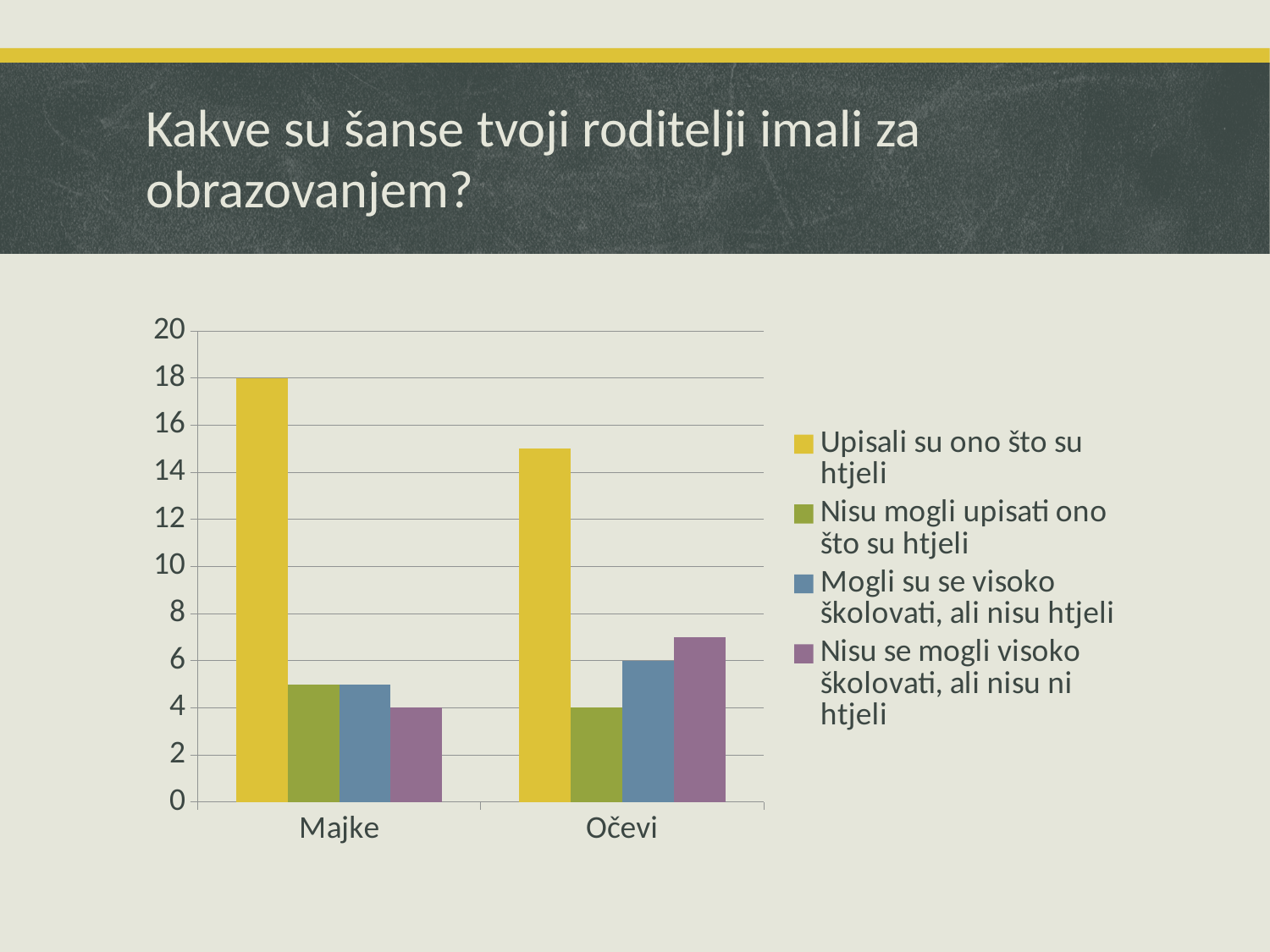
What is the value for 'Nisu mogli upisati ono što su htjeli' in the Očevi category? 4 What colour are the bars for 'Upisali su ono što su htjeli'? yellow What is the value for 'Mogli su se visoko školovati, ali nisu htjeli' in the Očevi category? 6 Which is larger: 'Upisali su ono što su htjeli' for Majke or for Očevi? Majke What is the value for 'Nisu se mogli visoko školovati, ali nisu ni htjeli' in the Majke category? 4 What kind of chart is shown on the slide? bar chart Which series has the lowest value in the Očevi category? Nisu mogli upisati ono što su htjeli Which series has the highest value in the Majke category? Upisali su ono što su htjeli How many series does the legend list? 4 How many categories are shown on the x axis? 2 Is the value for 'Upisali su ono što su htjeli' in the Očevi category greater or less than 14? greater What is the value for 'Upisali su ono što su htjeli' in the Majke category? 18